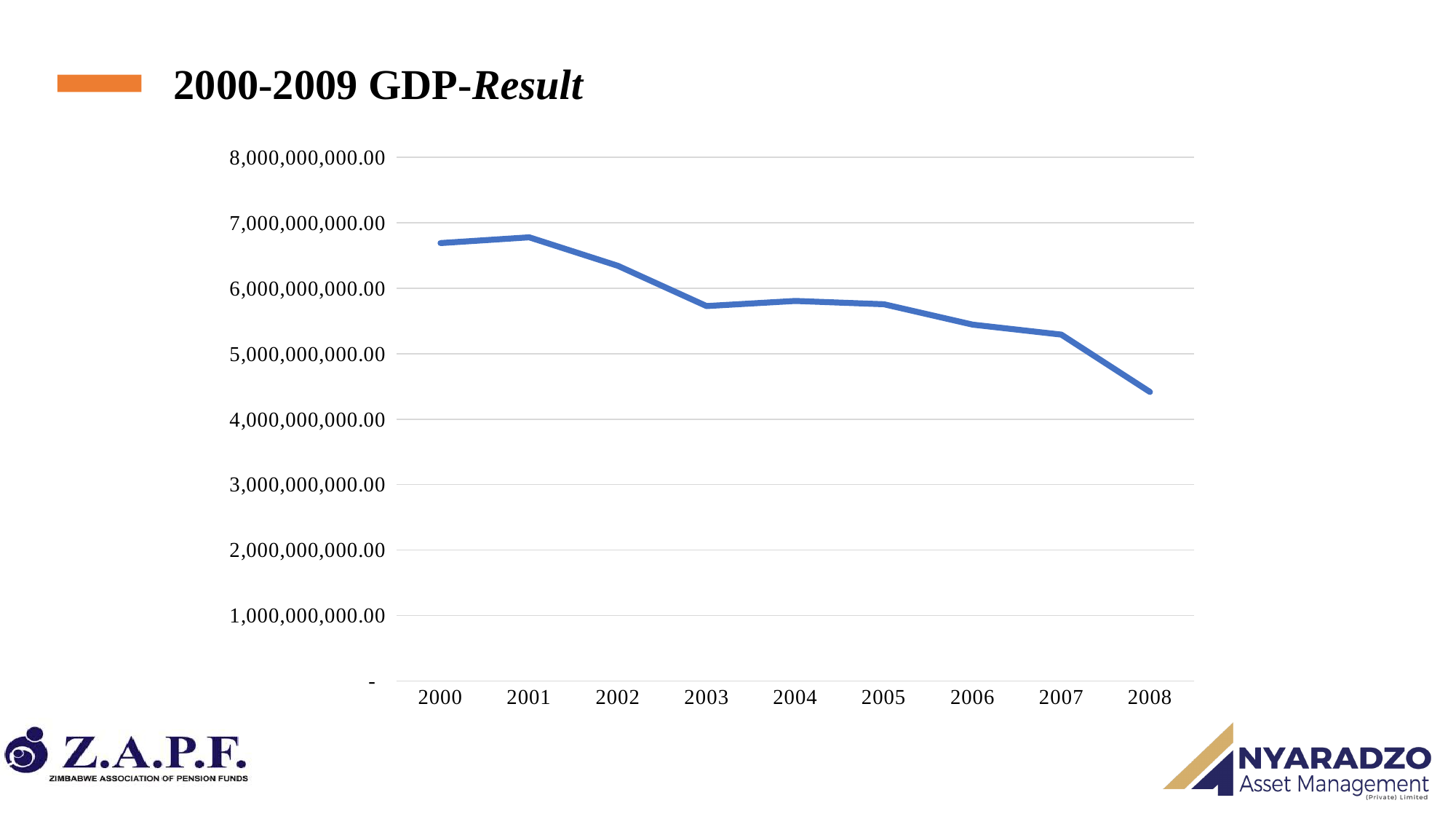
Is the value for 2000 greater or less than 6,000,000,000.00? greater Is the value for 2003 greater or less than 6,000,000,000.00? less Which year has the highest value? 2001 Which is larger, the value for 2002 or the value for 2007? 2002 What colour is the plotted line? blue Is the value for 2008 greater or less than 5,000,000,000.00? less Do the values generally rise or fall from 2000 to 2008? fall What kind of chart is shown on the slide? line chart How many years are plotted along the x axis? 9 Which year has the lowest value? 2008 What is the title of the slide? 2000-2009 GDP-Result